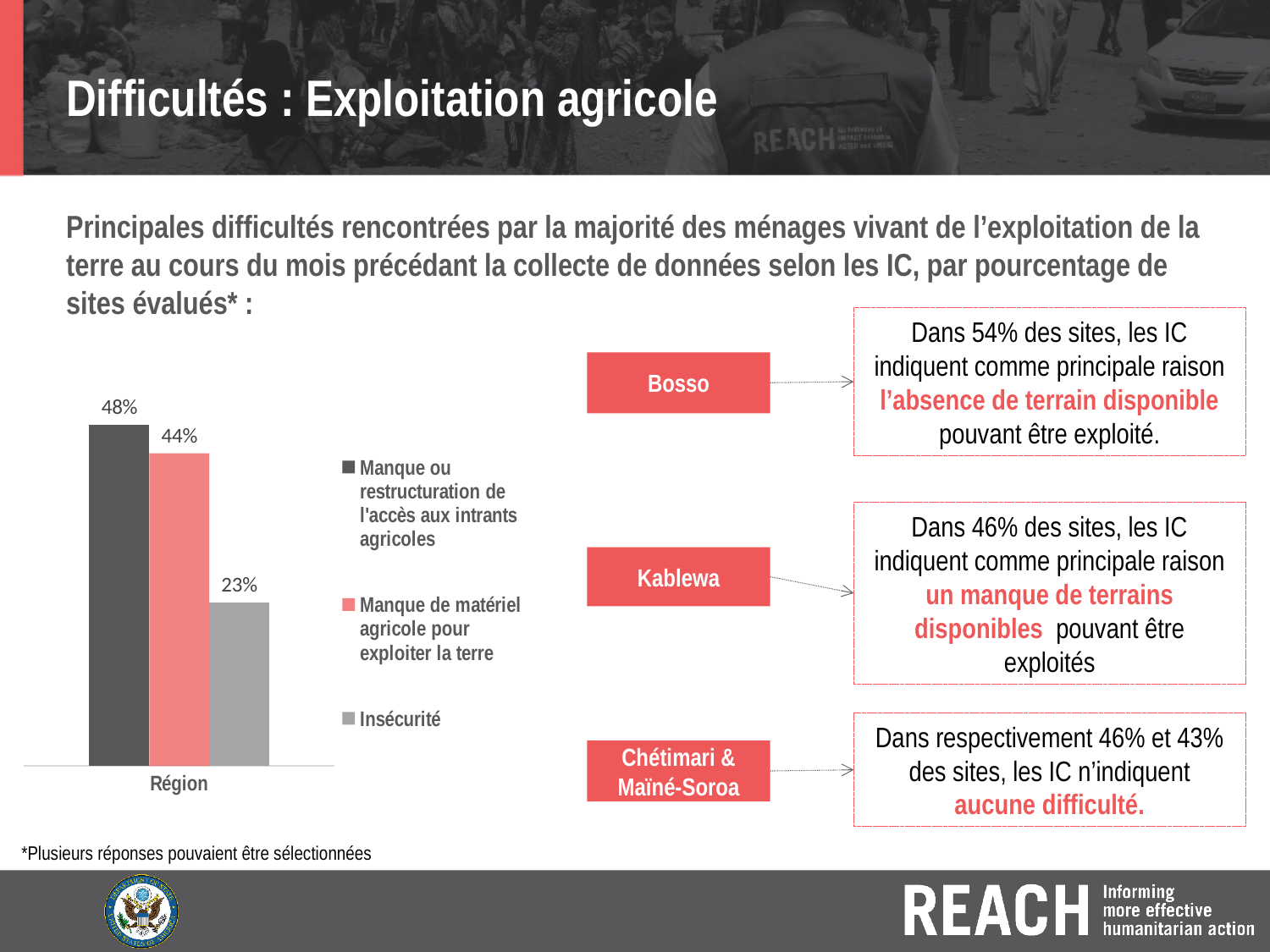
Which series has the highest value in the chart? Manque ou restructuration de l'accès aux intrants agricoles Which series has the lowest value in the chart? Insécurité What is the difference between the values for "Manque ou restructuration de l'accès aux intrants agricoles" and "Manque de matériel agricole pour exploiter la terre"? 4% What is the difference between the values for "Manque ou restructuration de l'accès aux intrants agricoles" and "Insécurité"? 25% What is the value for "Insécurité" in the Région category? 23% What is the value for "Manque de matériel agricole pour exploiter la terre" in the Région category? 44% What is the value for "Manque ou restructuration de l'accès aux intrants agricoles" in the Région category? 48% What is the label of the single category on the x axis of the chart? Région What kind of chart is shown on the slide? Bar chart How many categories are shown on the x axis of the chart? 1 Which is larger: the value for "Manque de matériel agricole pour exploiter la terre" or the value for "Insécurité"? Manque de matériel agricole pour exploiter la terre How many series does the legend list? 3